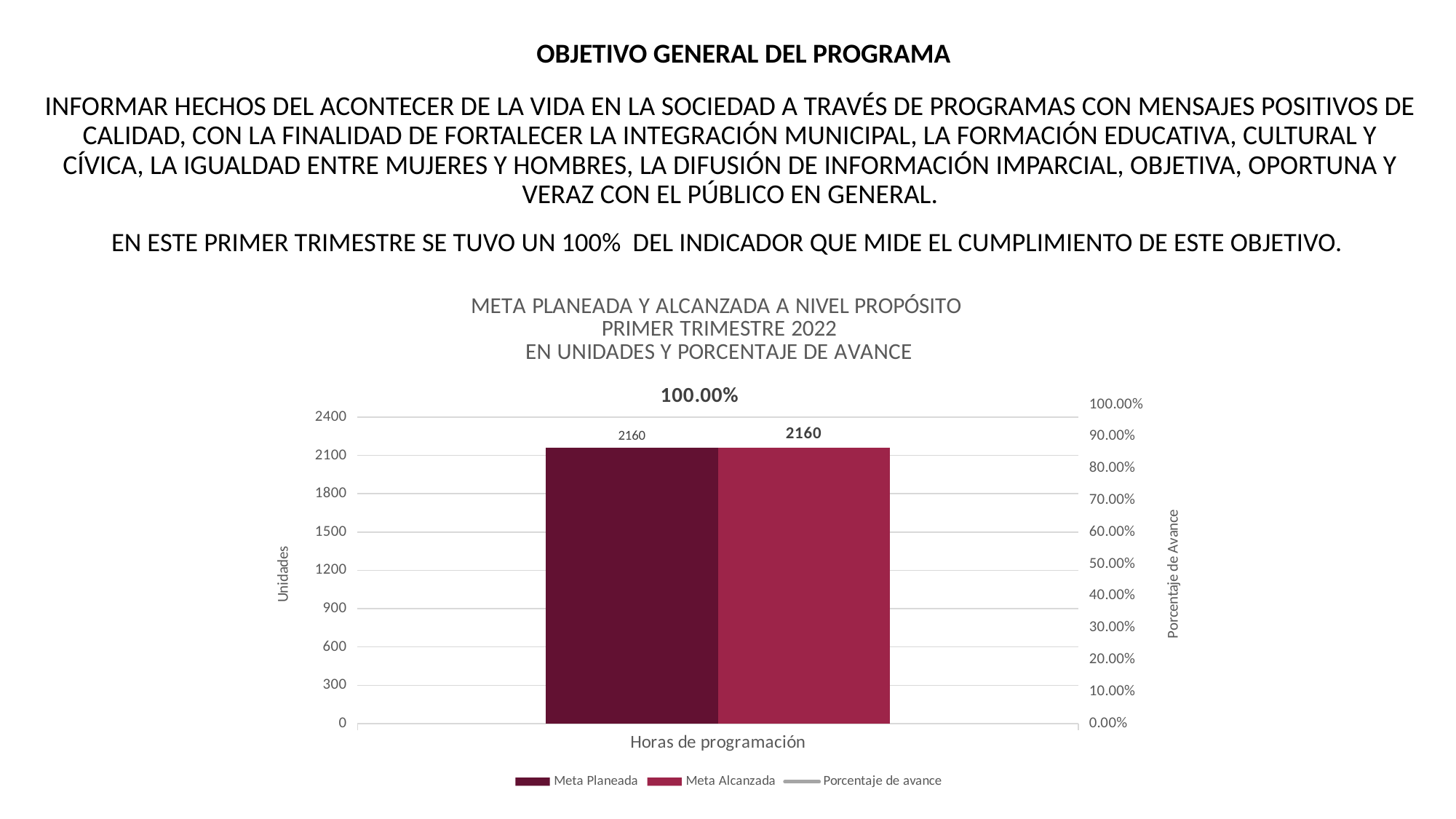
What is the value of Meta Planeada for Horas de programación? 2160 What is the label of the right vertical axis of the chart? Porcentaje de Avance What is the label of the left vertical axis of the chart? Unidades Is the value of Meta Planeada for Horas de programación greater or less than 1800? greater What is the difference between Meta Planeada and Meta Alcanzada for Horas de programación? 0 What is the Porcentaje de avance shown for Horas de programación? 100.00% What kind of chart is shown on the slide? bar chart How many categories are shown on the x axis of the chart? 1 Is the value of Meta Alcanzada for Horas de programación greater or less than 2400? less What is the value of Meta Alcanzada for Horas de programación? 2160 How many series does the legend list? 3